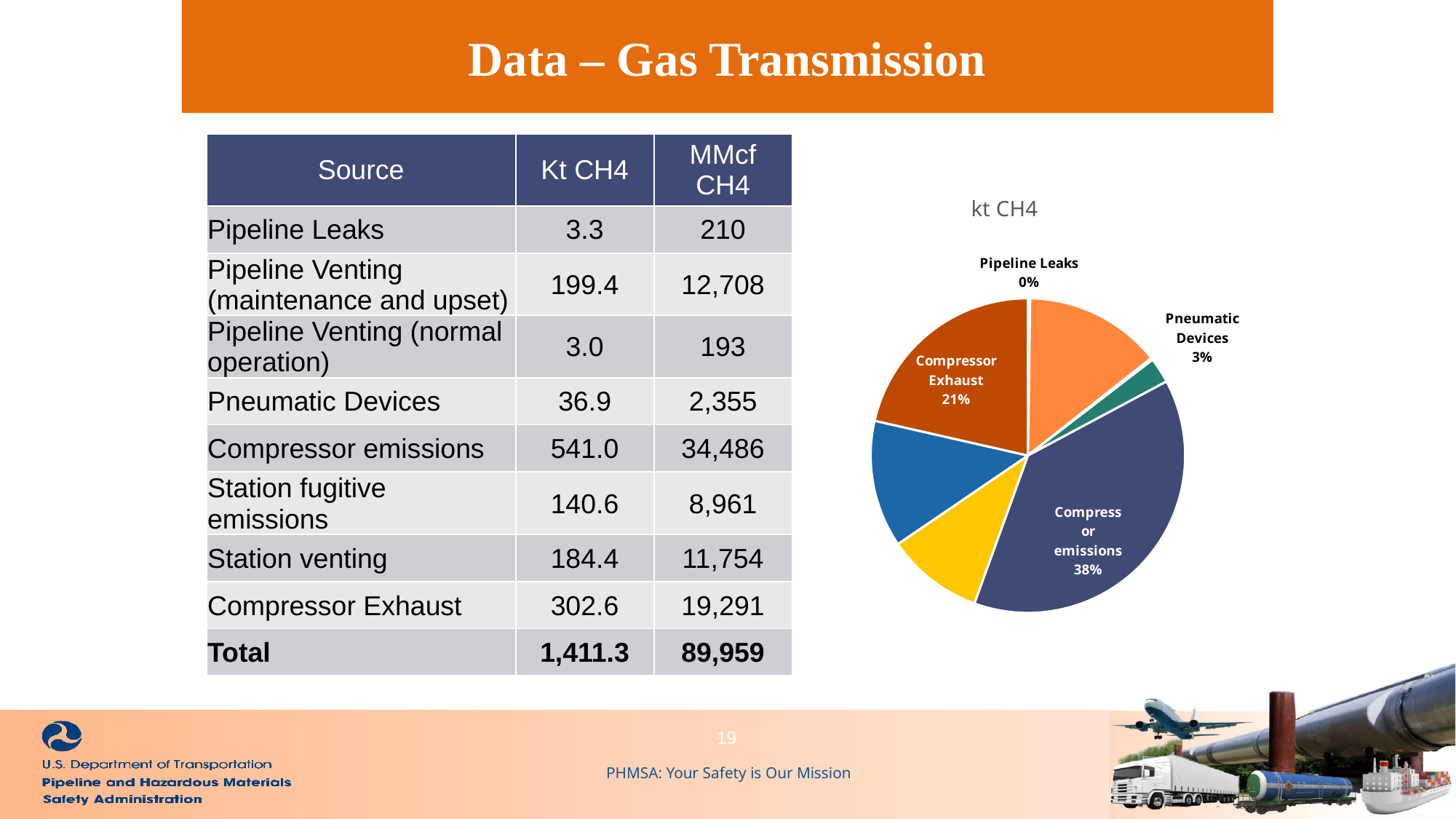
What share of the pie does Compressor Exhaust have? 21% Which is larger in the pie chart, Compressor Exhaust or Pneumatic Devices? Compressor Exhaust Which labelled slice of the pie chart is the smallest? Pipeline Leaks What kind of chart is shown on the slide? pie chart What is the difference in percentage points between the Compressor emissions slice and the Compressor Exhaust slice? 17% Which labelled slice of the pie chart is the largest? Compressor emissions What share of the pie does Compressor emissions have? 38% Which is larger in the pie chart, Compressor emissions or Compressor Exhaust? Compressor emissions What share of the pie is labelled for Pipeline Leaks? 0% What colour is the Compressor emissions slice in the pie chart? dark blue What is the title of the pie chart? kt CH4